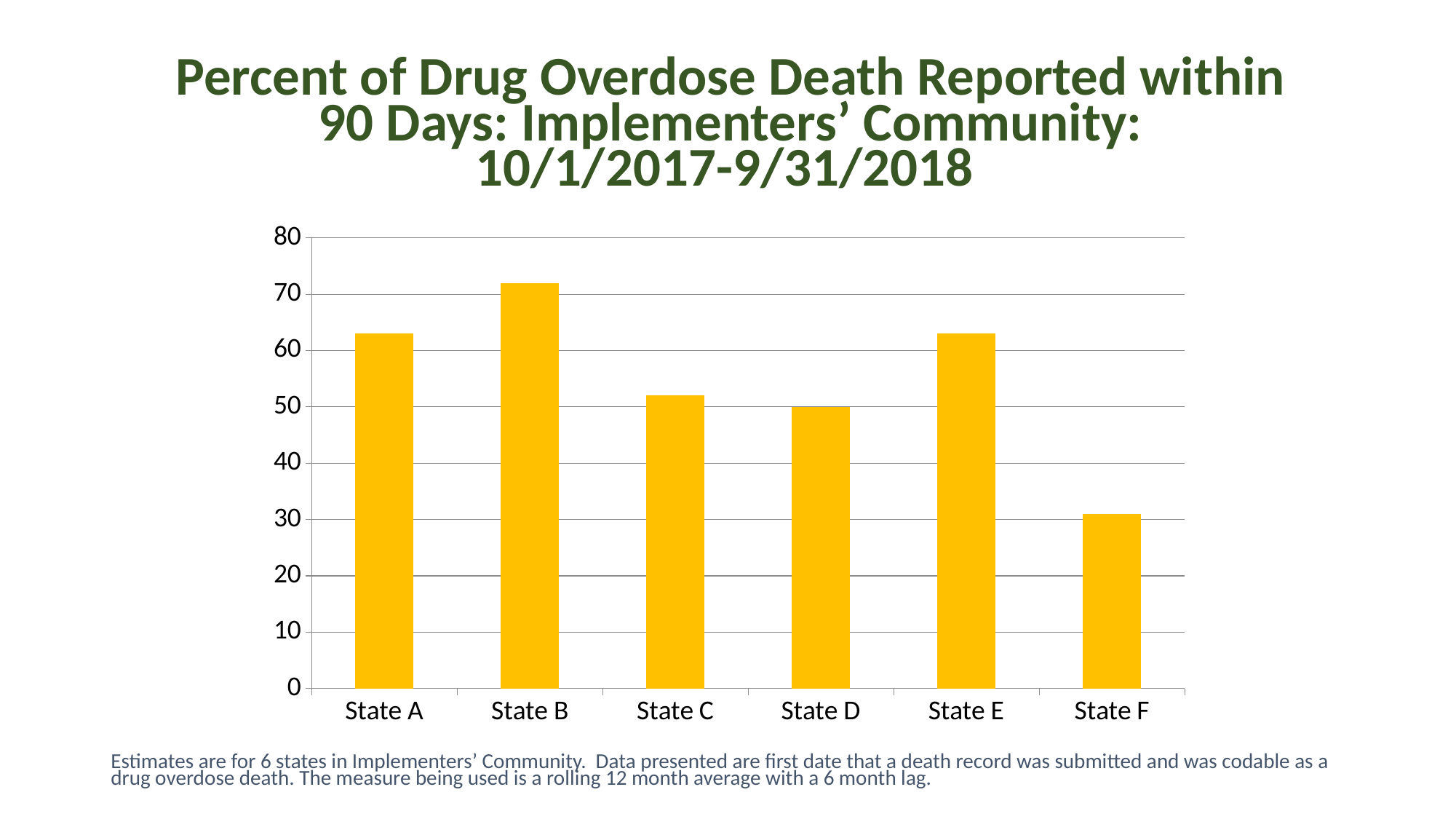
Is the value for State C greater or less than 60? less Which state has the highest percent of drug overdose deaths reported within 90 days? State B Which state has the lowest percent of drug overdose deaths reported within 90 days? State F Which has a higher value, State D or State F? State D How many states are shown on the x axis of the chart? 6 Is the value for State A greater or less than 60? greater Is the value for State B greater or less than 80? less What kind of chart is shown on the slide? bar chart Which has a higher value, State B or State C? State B What colour are the bars in the chart? yellow What is the title of the chart? Percent of Drug Overdose Death Reported within 90 Days: Implementers' Community: 10/1/2017-9/31/2018